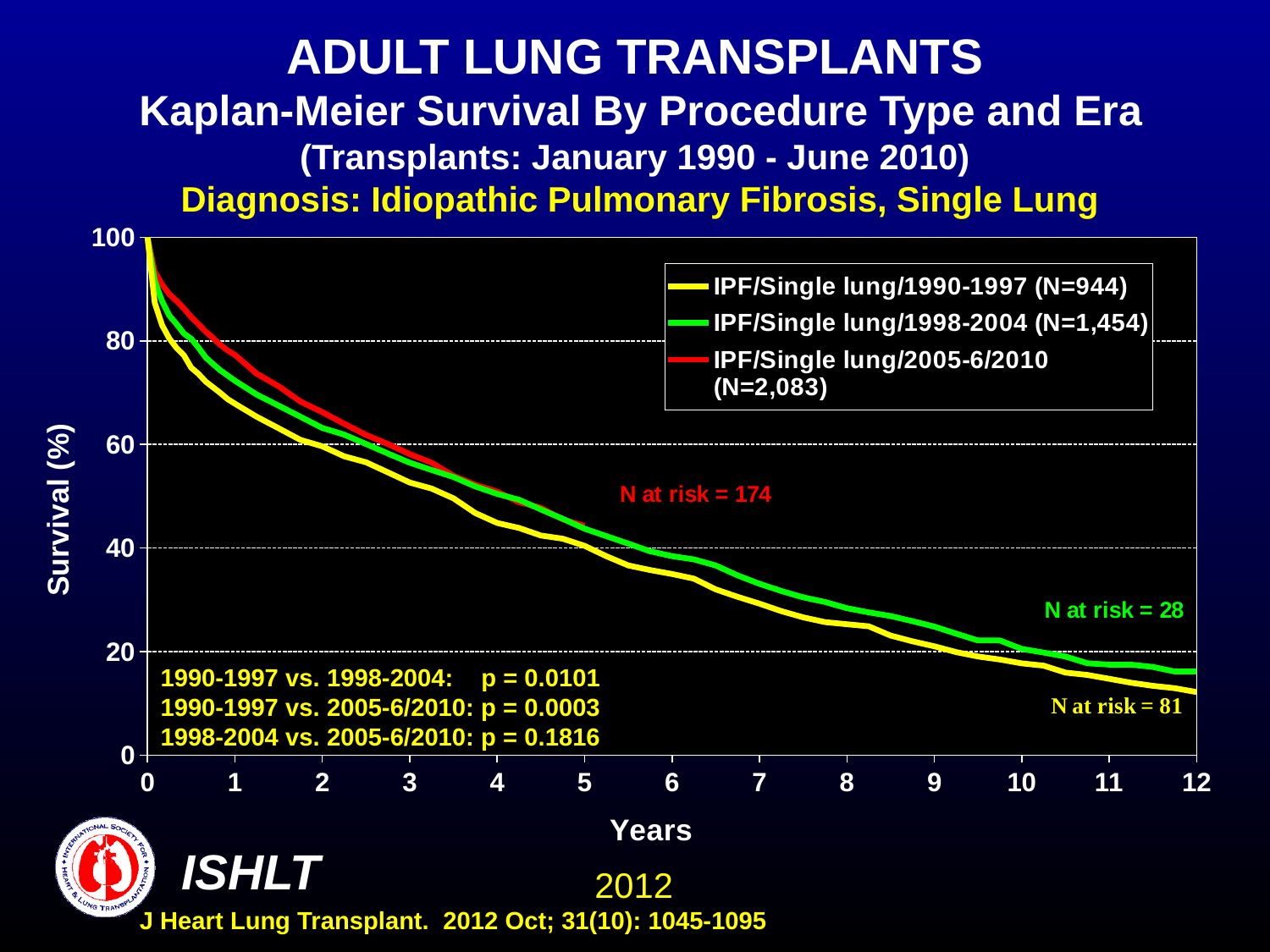
What is the N for the IPF/Single lung/1990-1997 series in the legend? 944 Which era series has the largest N in the legend? IPF/Single lung/2005-6/2010 Which era series has the smallest N in the legend? IPF/Single lung/1990-1997 Do the survival curves rise or fall as years increase? fall How many series does the legend list? 3 What is the N at risk shown for the 1998-2004 (green) curve? 28 What is the p-value shown for 1990-1997 vs. 2005-6/2010? 0.0003 At 1 year, which curve shows higher survival: 1990-1997 or 2005-6/2010? 2005-6/2010 What is the N for the IPF/Single lung/2005-6/2010 series in the legend? 2,083 Is the survival value for the 2005-6/2010 curve at 1 year greater or less than 60? greater What kind of chart is shown on the slide? line chart Is the survival value for the 1990-1997 curve at 12 years greater or less than 20? less